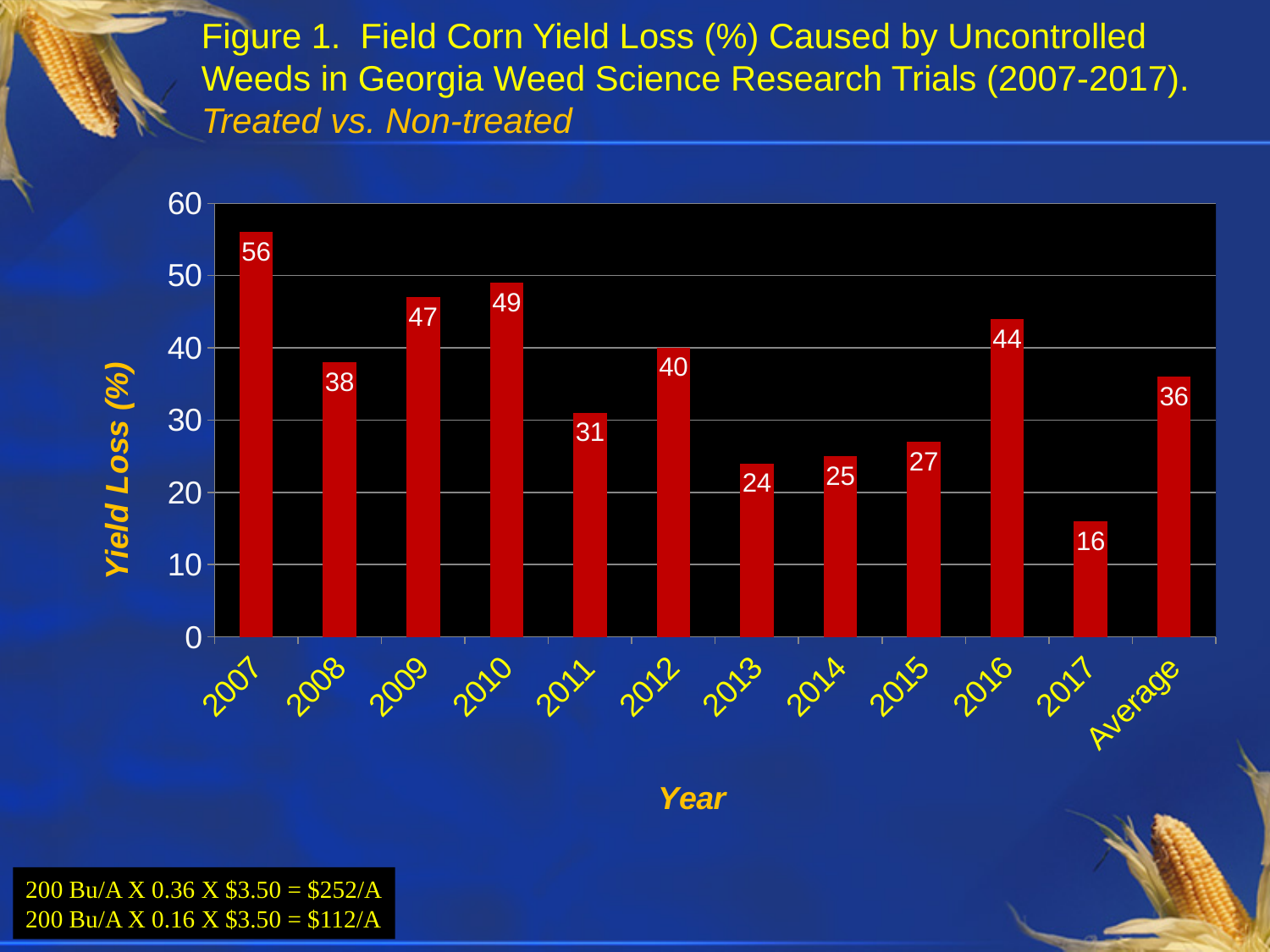
Which year has the lowest yield loss? 2017 Is the value for 2013 greater or less than 30? less What is the yield loss value for 2007? 56 What is the yield loss value for 2017? 16 Which year has a larger yield loss, 2012 or 2016? 2016 What is the label of the y axis? Yield Loss (%) How many bars are plotted in the chart? 12 Do the values rise or fall from 2013 to 2016? rise Which year has the highest yield loss? 2007 What is the difference between the yield loss in 2010 and in 2011? 18 What is the value shown for the Average bar? 36 What kind of chart is shown on the slide? bar chart